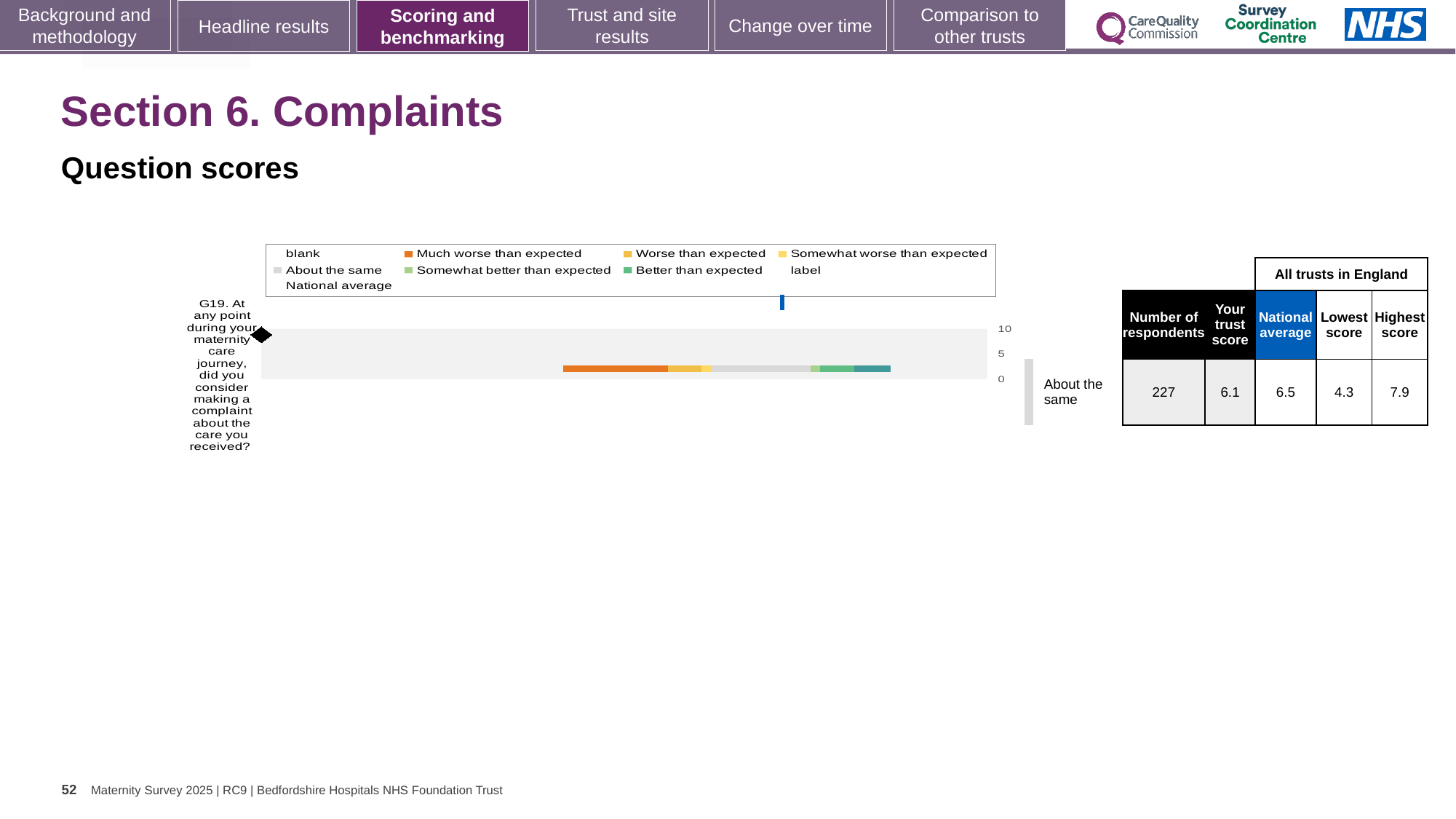
What is the national average score for question G19? 6.5 What is the difference between the highest and lowest scores for question G19? 3.6 For question G19, which is larger: the trust's score or the national average? national average What is the lowest score among all trusts in England for question G19? 4.3 What kind of chart is used to show the G19 question score? bar chart How many survey questions are plotted in the chart? 1 What is the trust's score for question G19? 6.1 By how much is the national average above the trust's score for question G19? 0.4 Which benchmark category is shown next to the chart for question G19? About the same Which colour does the legend use for 'Much worse than expected'? orange What is the highest score among all trusts in England for question G19? 7.9 How many respondents answered question G19? 227